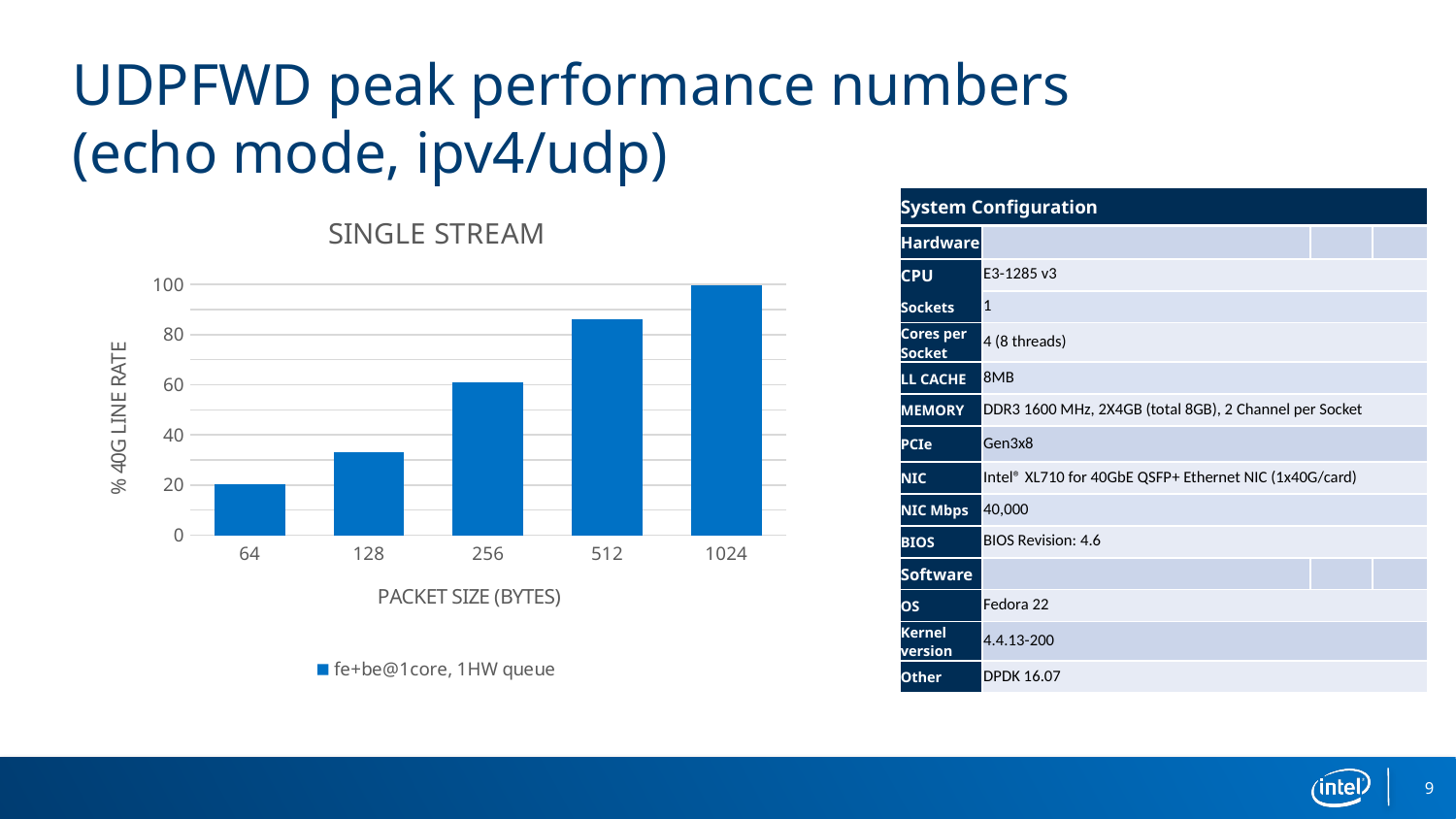
What is the title of the chart? SINGLE STREAM Which packet size has the lowest % 40G line rate? 64 Which packet size has the highest % 40G line rate? 1024 How many packet sizes are plotted on the x axis? 5 Does the % 40G line rate rise or fall as packet size increases along the x axis? rise What series name does the legend show? fe+be@1core, 1HW queue What kind of chart is shown on the slide? bar chart Which has the larger % 40G line rate, packet size 256 or packet size 512? 512 How many series does the legend list? 1 Is the value for packet size 512 greater or less than 80? greater Is the value for packet size 256 greater or less than 40? greater Is the value for packet size 128 greater or less than 40? less